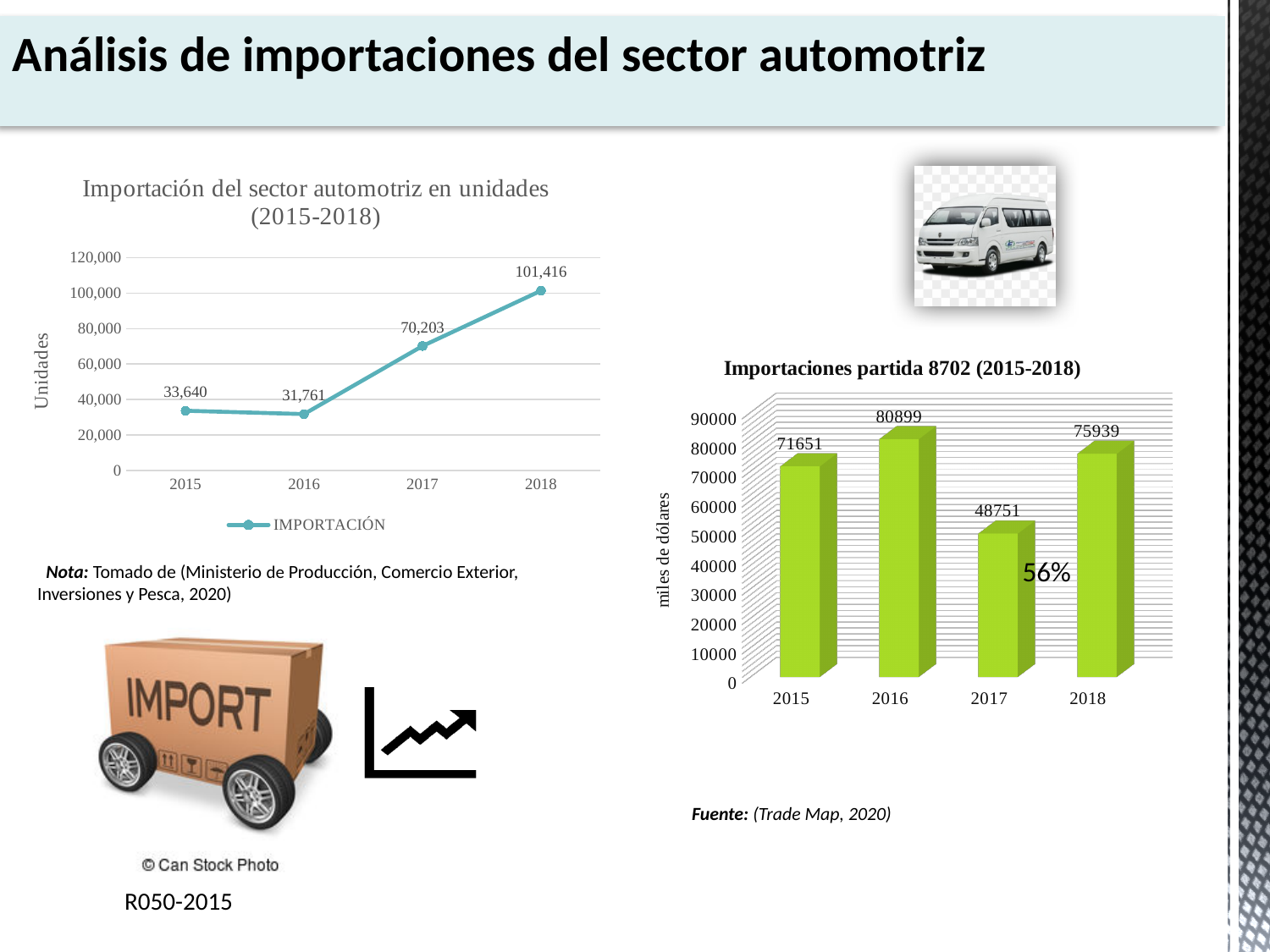
In the chart 'Importaciones partida 8702 (2015-2018)', which year has the highest value? 2016 In the chart 'Importación del sector automotriz en unidades (2015-2018)', what is the value for 2016? 31,761 In the chart 'Importaciones partida 8702 (2015-2018)', what is the value for 2017? 48751 In the chart 'Importaciones partida 8702 (2015-2018)', how many years are plotted? 4 In the chart 'Importación del sector automotriz en unidades (2015-2018)', what kind of chart is shown? Line chart In the chart 'Importación del sector automotriz en unidades (2015-2018)', what is the name of the series in the legend? IMPORTACIÓN In the chart 'Importación del sector automotriz en unidades (2015-2018)', what is the value for 2018? 101,416 In the chart 'Importaciones partida 8702 (2015-2018)', what kind of chart is shown? Bar chart In the chart 'Importaciones partida 8702 (2015-2018)', which is larger, the value for 2015 or the value for 2018? 2018 In the chart 'Importación del sector automotriz en unidades (2015-2018)', what is the difference between the 2017 and 2015 values? 36,563 In the chart 'Importaciones partida 8702 (2015-2018)', what is the difference between the 2016 and 2017 values? 32148 In the chart 'Importación del sector automotriz en unidades (2015-2018)', which year has the lowest value? 2016